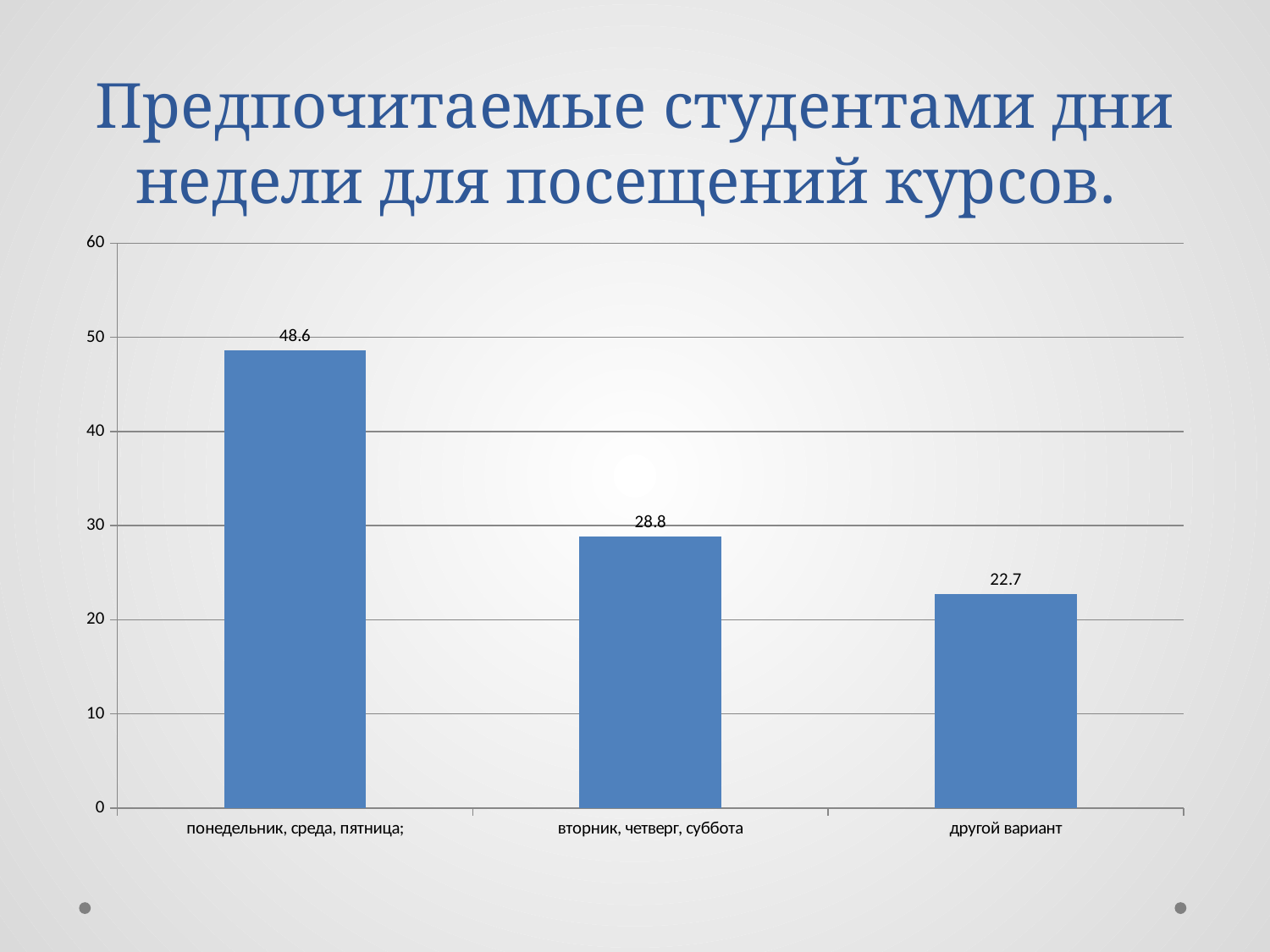
Which category has the highest value? понедельник, среда, пятница; What is the value for "понедельник, среда, пятница;"? 48.6 Which category has the lowest value? другой вариант How many categories are shown on the chart? 3 What is the difference between the values for "вторник, четверг, суббота" and "другой вариант"? 6.1 What kind of chart is shown on the slide? bar chart Is the value for "понедельник, среда, пятница;" greater or less than 40? greater What is the title of the slide? Предпочитаемые студентами дни недели для посещений курсов. What is the value for "другой вариант"? 22.7 What is the difference between the values for "понедельник, среда, пятница;" and "вторник, четверг, суббота"? 19.8 What is the value for "вторник, четверг, суббота"? 28.8 Which is larger: the value for "вторник, четверг, суббота" or for "другой вариант"? вторник, четверг, суббота